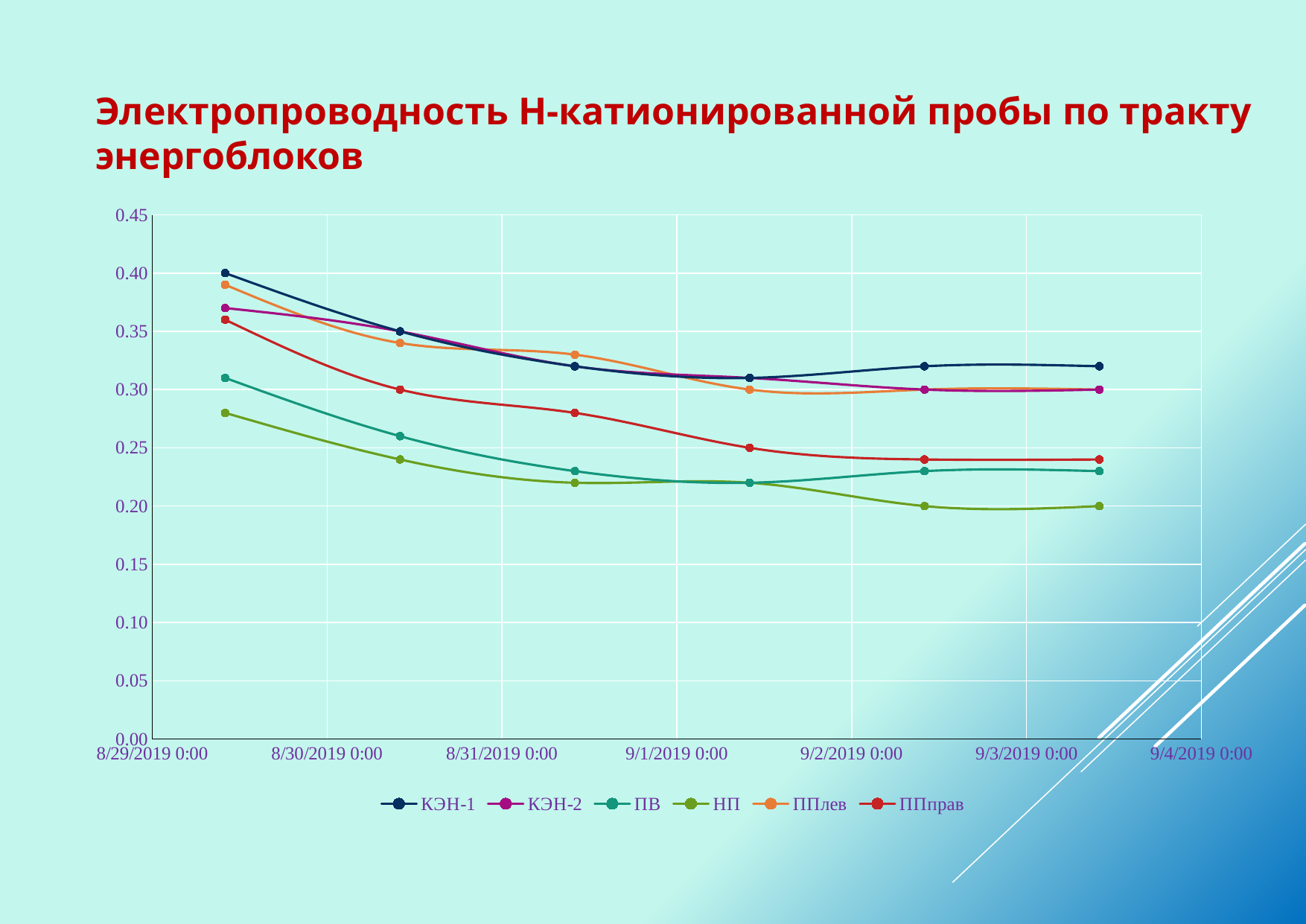
What is the value of НП at the last data point (on 9/3/2019)? 0.20 What kind of chart is shown on the slide? line chart Is the value for НП at the first data point greater or less than 0.25? greater Is the value for КЭН-1 at the last data point greater or less than 0.30? greater What is the value of ППправ at the second data point (on 8/30/2019)? 0.30 Is the value for ППправ at the last data point greater or less than 0.25? less Which is larger at the last data point: КЭН-1 or ПВ? КЭН-1 Do the values of the ППправ series rise or fall from the first to the last date? fall How many series does the legend list? 6 What is the value of КЭН-1 at the first data point (on 8/29/2019)? 0.40 How many data points does the КЭН-1 series have? 6 Which series has the lowest values across the whole period? НП